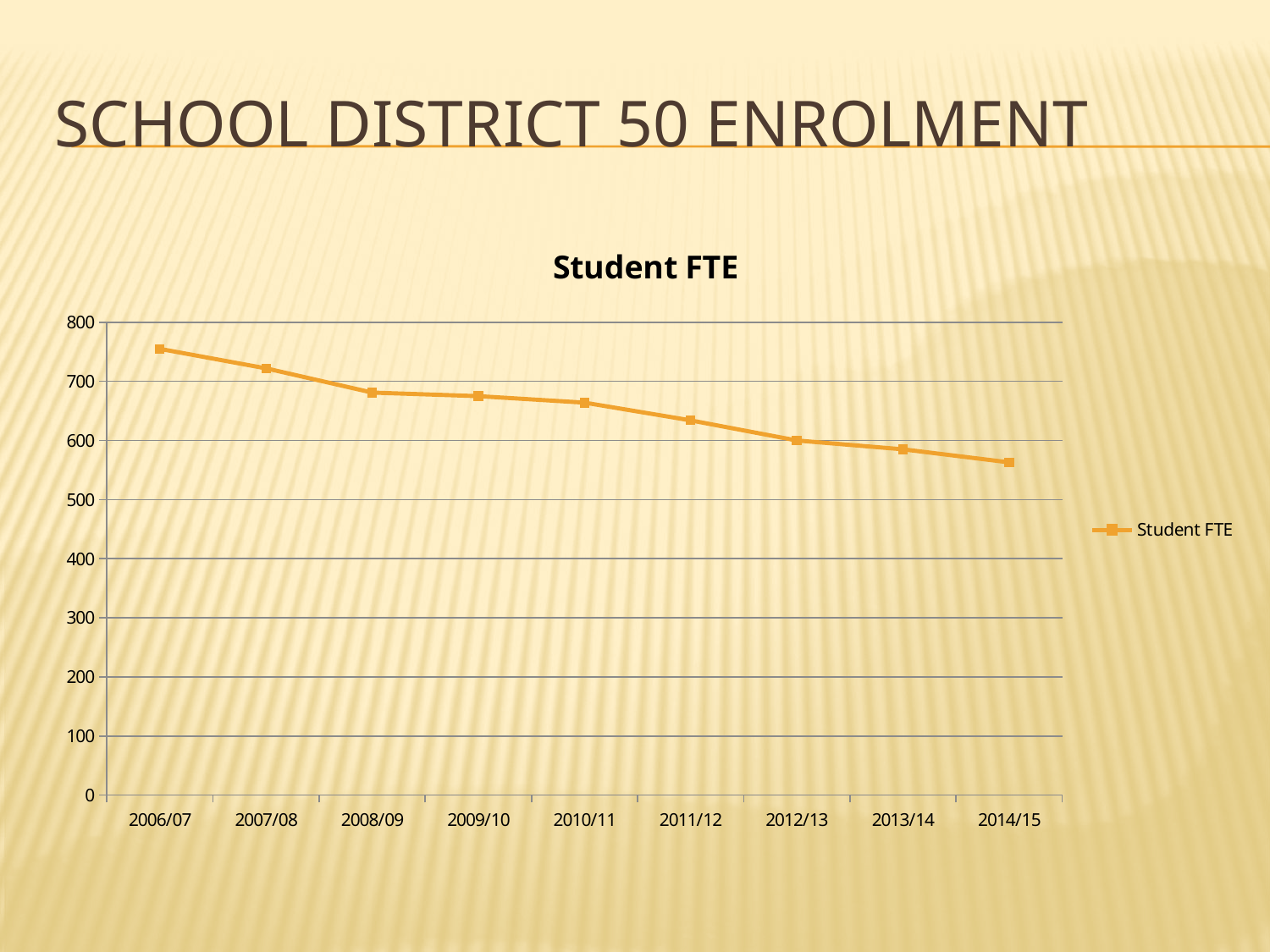
Is the Student FTE value for 2011/12 greater or less than 600? greater How many series does the legend list? 1 Which is larger, the Student FTE for 2007/08 or for 2011/12? 2007/08 What kind of chart is shown on the slide? line chart Which school year has the highest Student FTE? 2006/07 Which school year has the lowest Student FTE? 2014/15 Do the Student FTE values rise or fall from 2006/07 to 2014/15? fall What is the title of the chart? Student FTE Is the Student FTE value for 2014/15 greater or less than 600? less How many school years are plotted on the x axis? 9 Is the Student FTE value for 2006/07 greater or less than 700? greater